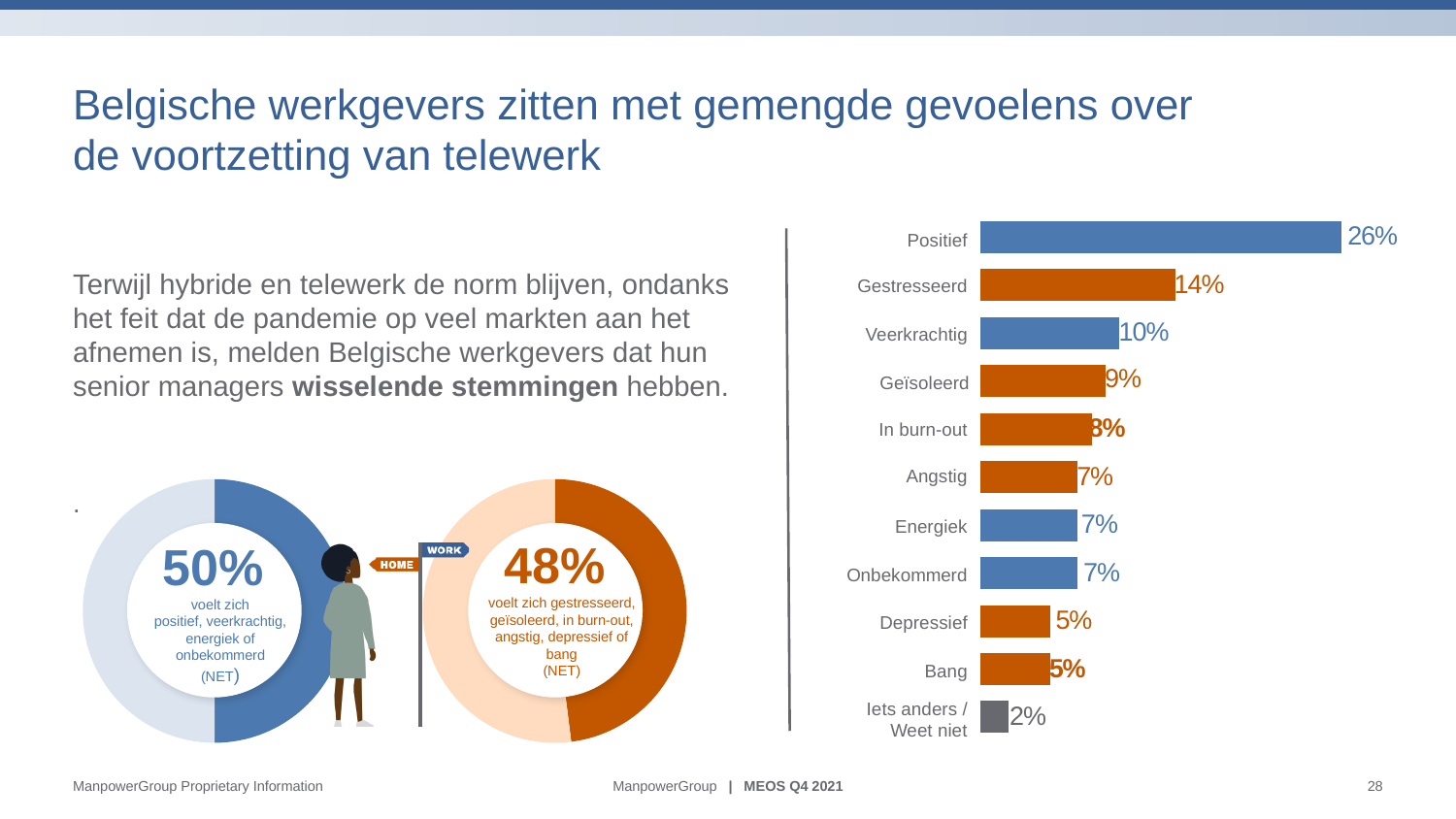
In the bar chart on the right, which is larger: the value for Veerkrachtig or the value for Depressief? Veerkrachtig In the bar chart on the right, what is the value for Gestresseerd? 14% In the bar chart on the right, what is the value for Geïsoleerd? 9% In the bar chart on the right, which category has the highest value? Positief In the bar chart on the right, which category has the lowest value? Iets anders / Weet niet What kind of chart is shown on the right side of the slide? Bar chart In the left donut graphic, what percentage of employers feel positive, resilient, energetic or carefree (NET)? 50% In the bar chart on the right, what is the value for Positief? 26% In the bar chart on the right, what is the value for Iets anders / Weet niet? 2% In the bar chart on the right, what is the difference between the values for Positief and Gestresseerd? 12% How many categories does the bar chart on the right show? 11 In the bar chart on the right, what is the difference between the values for Veerkrachtig and In burn-out? 2%